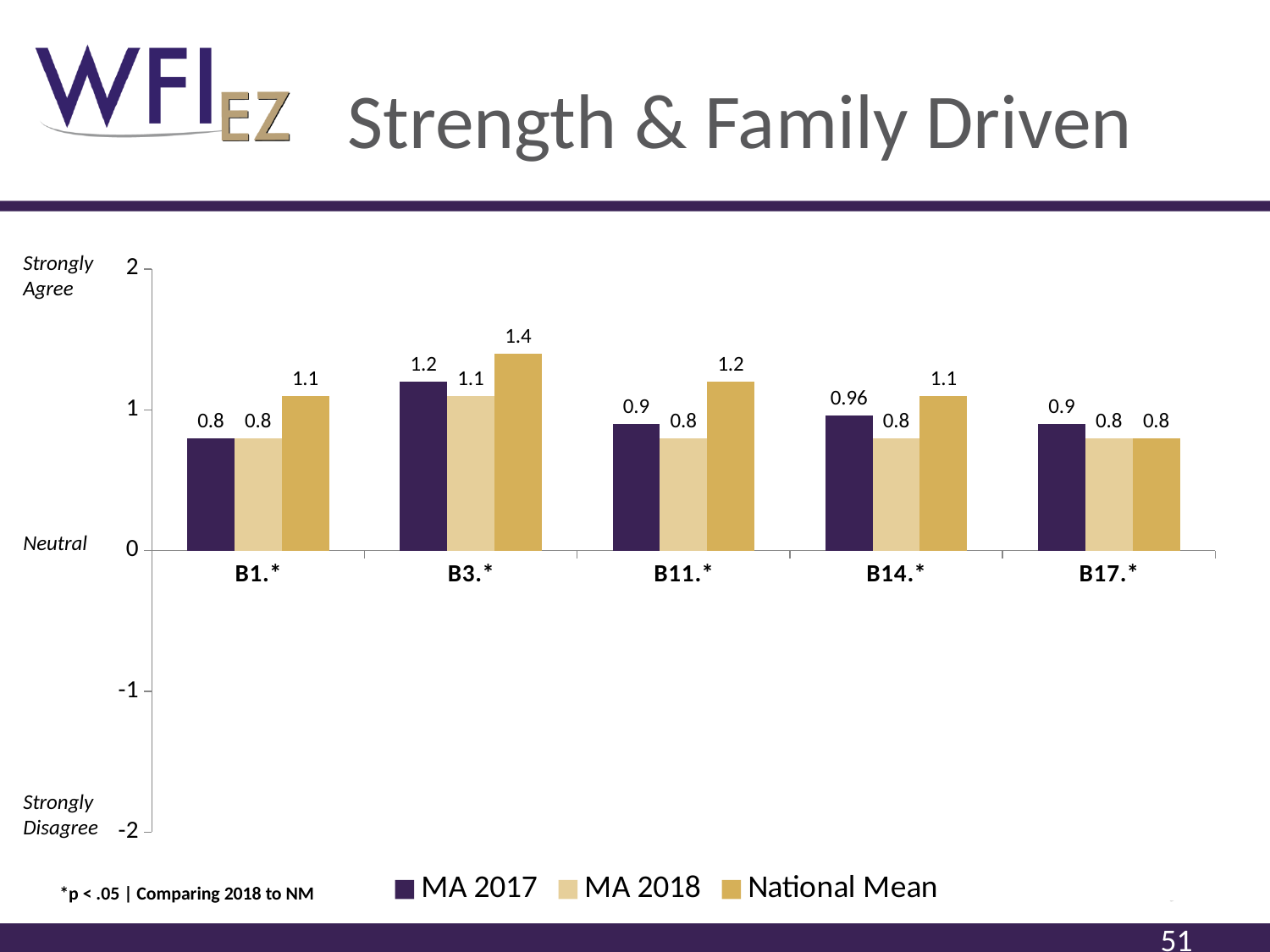
What is the MA 2018 value for B11.*? 0.8 Which category has the highest MA 2017 value? B3.* What is the National Mean value for B3.*? 1.4 How many categories are shown on the x axis? 5 What kind of chart is shown on the slide? Bar chart What label is shown at the top of the y axis at the value 2? Strongly Agree What is the MA 2017 value for B14.*? 0.96 Which is larger for B14.*, the MA 2017 value or the National Mean value? National Mean What is the title of the slide? Strength & Family Driven What is the difference between the National Mean and MA 2018 values for B11.*? 0.4 Which category has the highest National Mean value? B3.* How many series does the legend list? 3